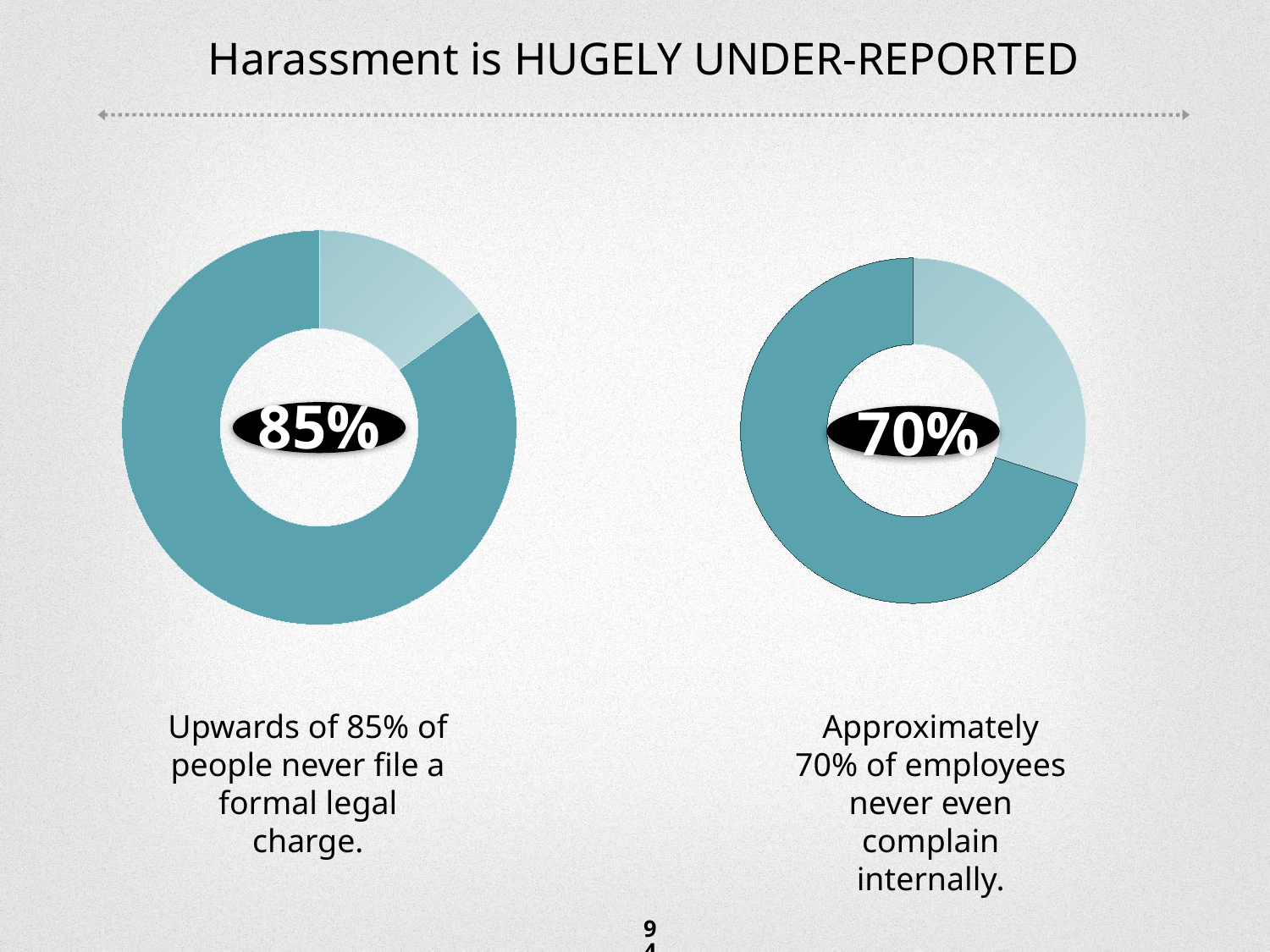
Which chart shows the larger highlighted percentage, the left chart or the right chart? the left chart What is the title of the slide containing the two doughnut charts? Harassment is HUGELY UNDER-REPORTED How many charts are shown on the slide? 2 In the left chart, what share of the doughnut does the large dark teal slice represent? 85% In the right chart, what share of the doughnut does the large dark teal slice represent? 70% In the right chart, which slice is smaller, the dark teal slice or the light teal slice? the light teal slice How many slices does each doughnut chart on the slide have? 2 What is the difference between the percentage shown in the left chart and the percentage shown in the right chart? 15% What percentage is printed in the centre of the right chart? 70% What percentage is printed in the centre of the left chart? 85% What kind of chart is shown on the left side of the slide? doughnut chart In the left chart, which slice is larger, the dark teal slice or the light teal slice? the dark teal slice